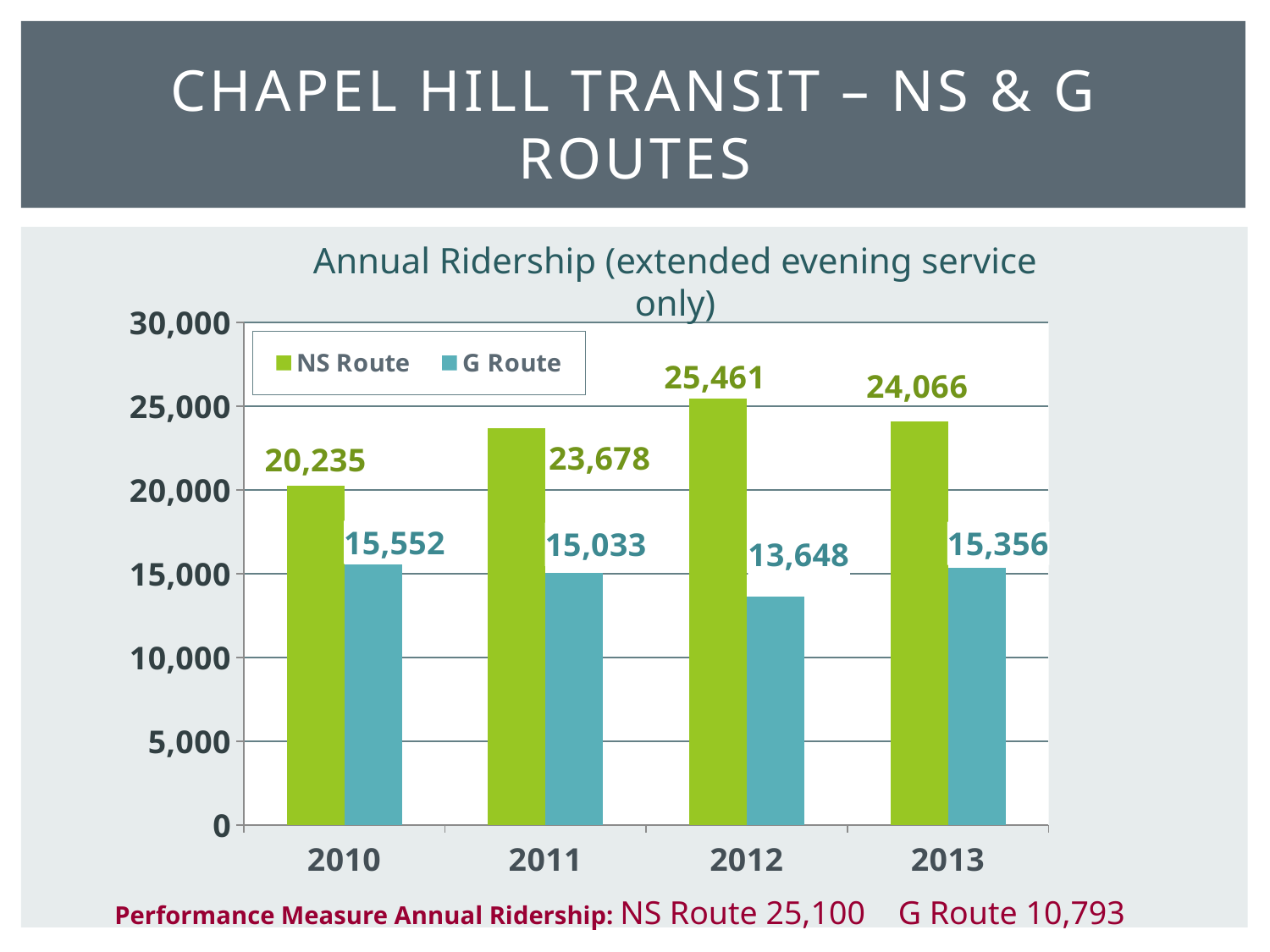
How many series does the legend list? 2 What kind of chart is shown on the slide? bar chart In which year was the NS Route ridership highest? 2012 In which year was the G Route ridership lowest? 2012 How many years are shown on the x axis? 4 What is the title of the chart? Annual Ridership (extended evening service only) What was the NS Route annual ridership in 2012? 25,461 Is the NS Route ridership in 2010 greater or less than 25,000? less What is the difference between NS Route and G Route ridership in 2011? 8,645 What was the NS Route annual ridership in 2013? 24,066 What was the G Route annual ridership in 2010? 15,552 Which route had higher ridership in 2013, NS Route or G Route? NS Route